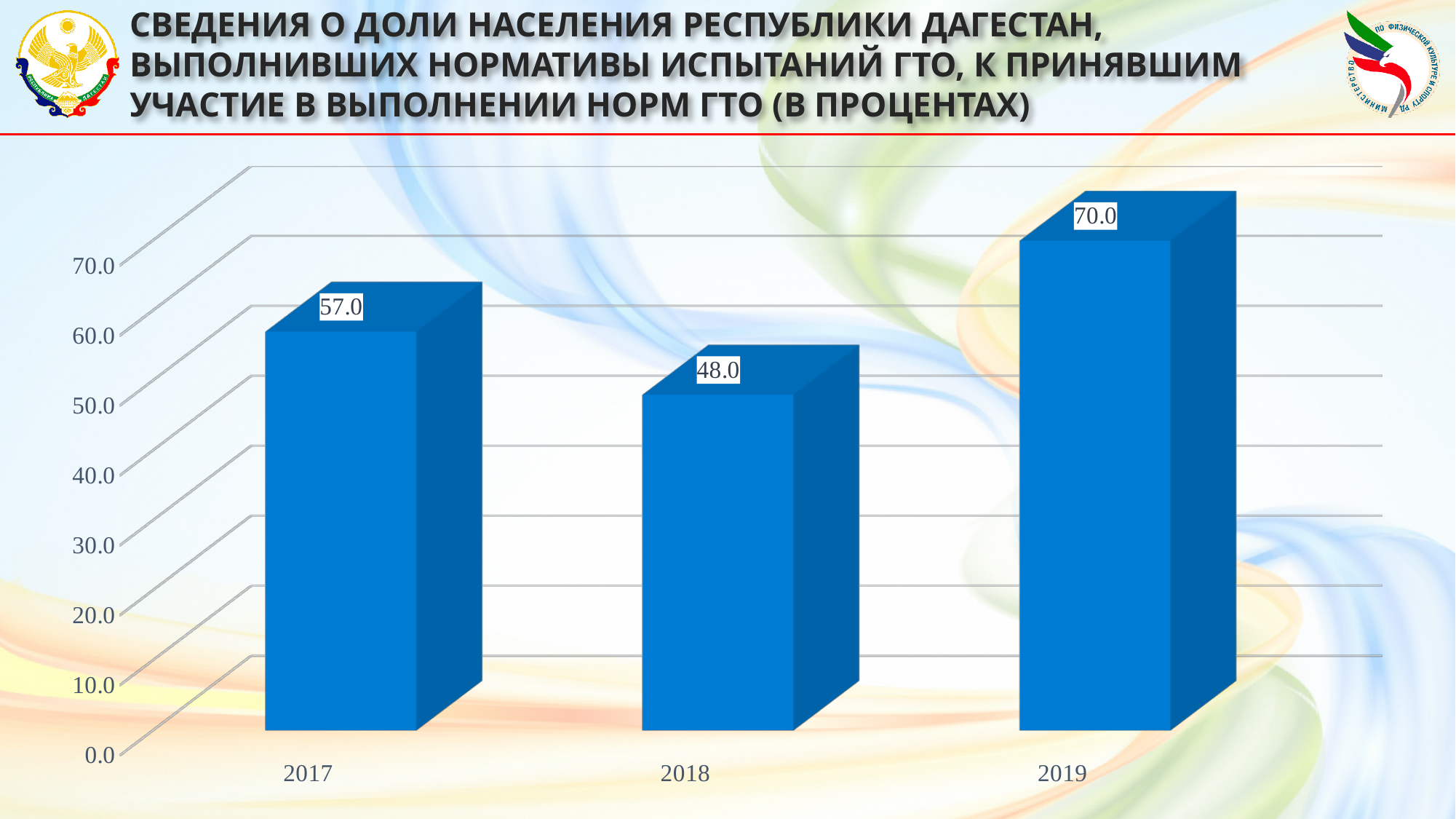
What is the difference between the values for 2019 and 2017? 13.0 How many years are shown on the chart? 3 What is the value for 2017? 57.0 What is the value for 2018? 48.0 Which is larger, the value for 2017 or the value for 2018? 2017 What kind of chart is shown on the slide? bar chart Which year has the highest value? 2019 What colour are the bars in the chart? blue What is the value for 2019? 70.0 Is the value for 2019 greater or less than 60.0? greater Which year has the lowest value? 2018 What is the difference between the values for 2017 and 2018? 9.0